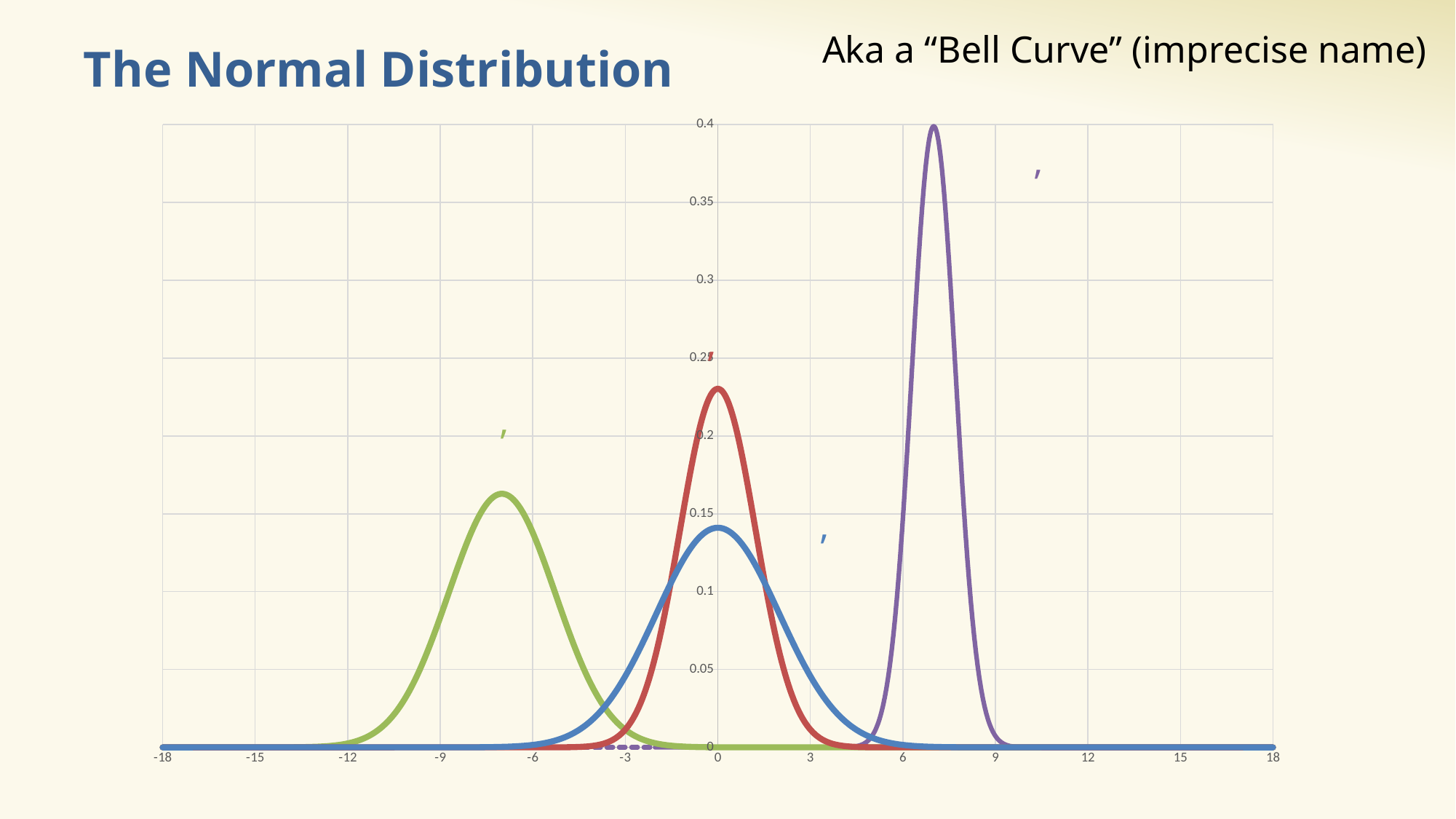
Is the peak of the red curve greater or less than 0.2? greater What kind of chart is shown on the slide? line chart Which curve peaks furthest to the left on the x axis? the green curve Which has the higher peak, the red curve or the blue curve? the red curve Is the peak of the purple curve greater or less than 0.35? greater Is the peak of the blue curve greater or less than 0.15? less Which curve has the lowest peak? the blue curve Which curve reaches the highest peak? the purple curve What is the title of the chart slide? The Normal Distribution How many curves are plotted on the chart? 4 What is the highest value shown on the y axis? 0.4